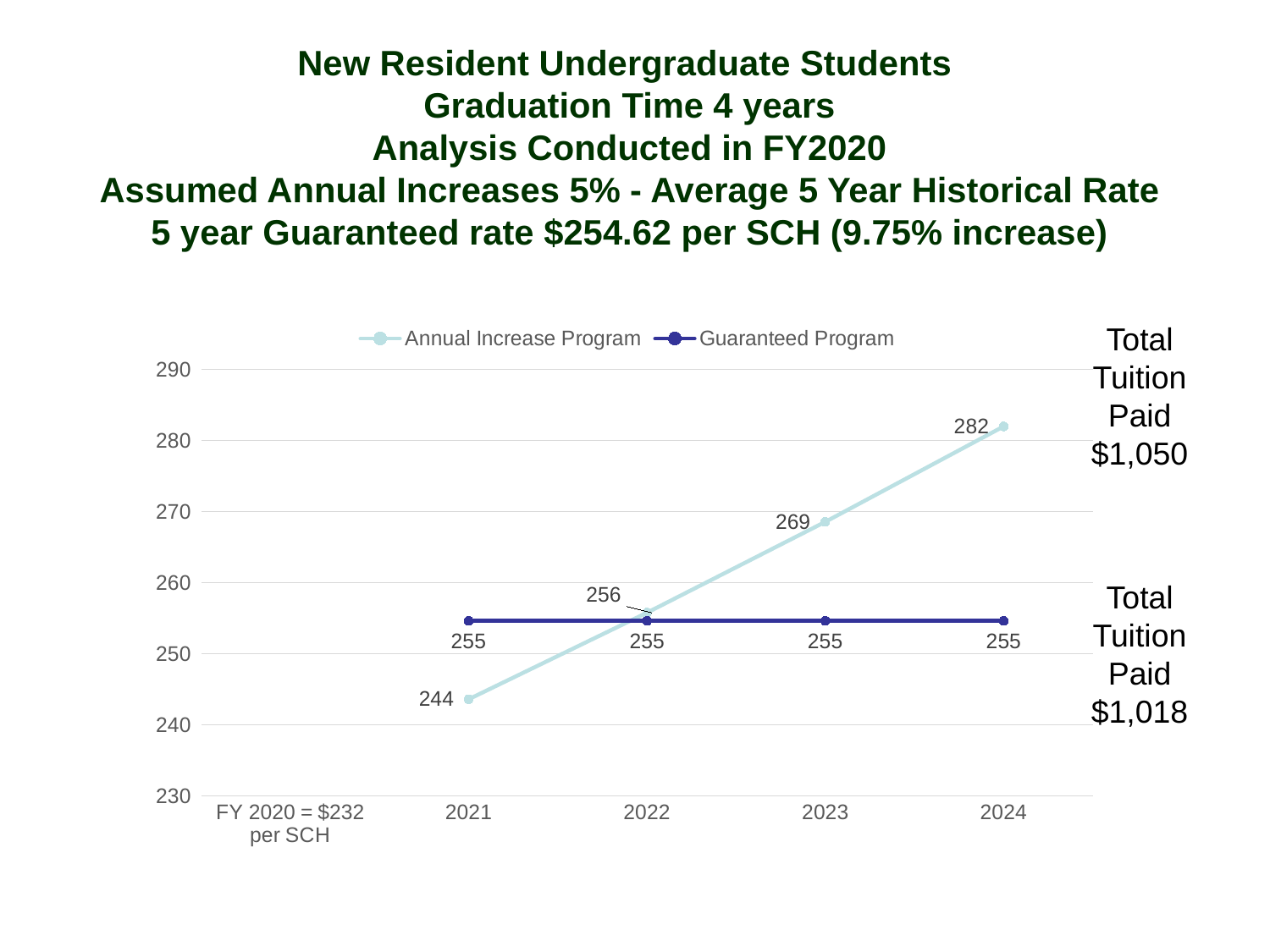
Which series has the larger value in 2023, Annual Increase Program or Guaranteed Program? Annual Increase Program What type of chart is shown on the slide? line chart Does the Annual Increase Program line rise or fall from 2021 to 2024? rise What is the value of the Guaranteed Program in 2023? 255 What is the value of the Annual Increase Program in 2021? 244 What is the difference between the Annual Increase Program value in 2024 and in 2021? 38 How many series does the legend list? 2 In which year is the Annual Increase Program value lowest? 2021 In which year is the Annual Increase Program value highest? 2024 How many data points are plotted for the Guaranteed Program line? 4 What is the value of the Annual Increase Program in 2024? 282 What total tuition paid is shown for the Annual Increase Program? $1,050